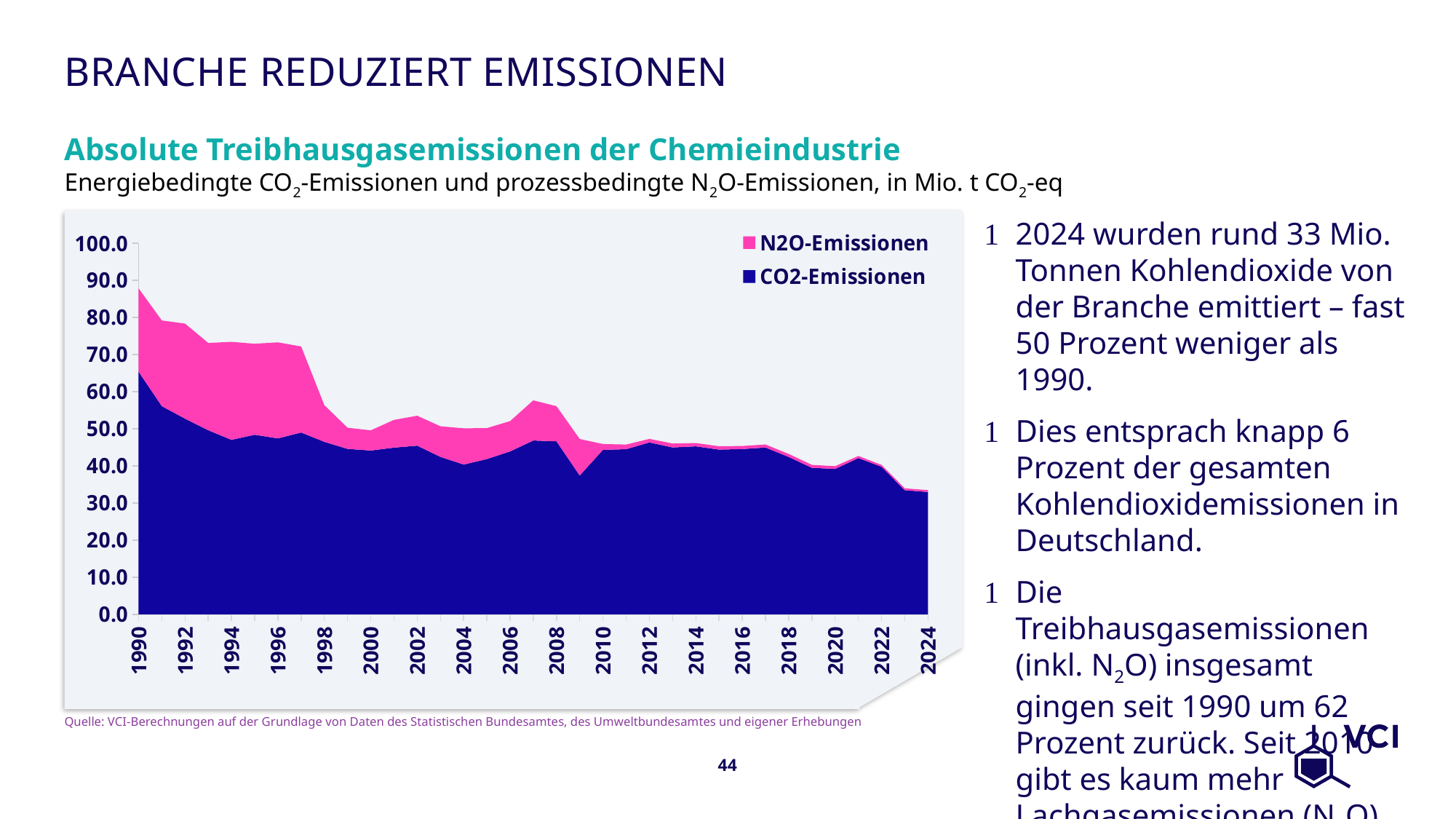
Do the total emissions in the chart rise or fall from 1990 to 2024? Fall Are the CO2-Emissionen in 2024 greater or less than 40? less Which year has higher total emissions, 1990 or 2024? 1990 Are the CO2-Emissionen in 1990 greater or less than 60? greater Which colour represents the CO2-Emissionen series in the chart? Dark blue Which year has higher CO2-Emissionen, 2007 or 2009? 2007 Are the total emissions in 1990 greater or less than 80? greater In which year are the total emissions (CO2 plus N2O) highest? 1990 Which two series are listed in the chart legend? N2O-Emissionen and CO2-Emissionen What kind of chart is shown on the slide? Stacked area chart How many series does the chart legend list? 2